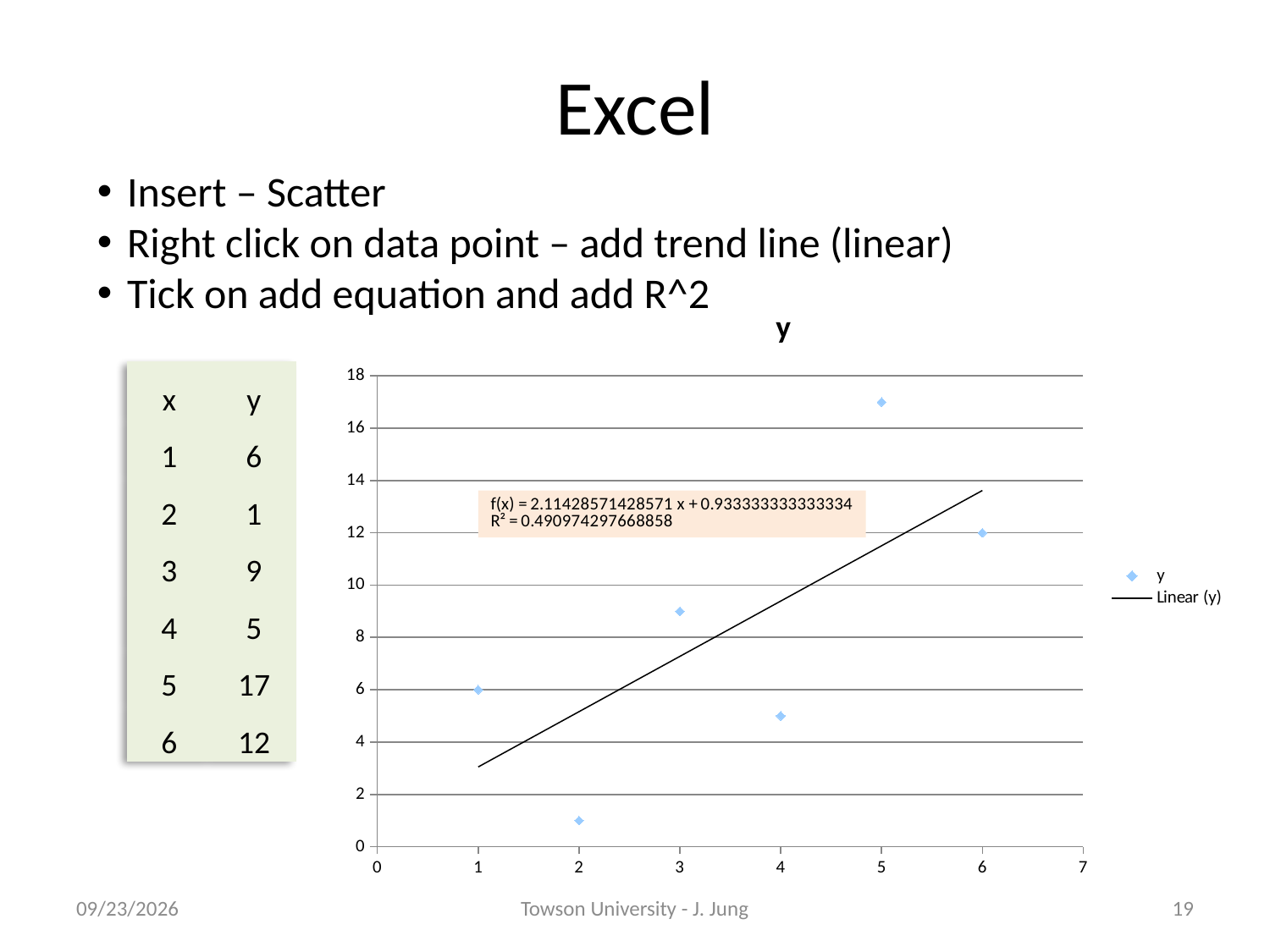
What is the R² value shown on the chart? 0.490974297668858 Is the y value at x = 1 greater or less than 4? greater How many entries does the chart legend list? 2 At which x value is y highest? 5 What is the y value at x = 2? 1 What kind of chart is shown on the slide? scatter chart Which is larger, the y value at x = 3 or the y value at x = 4? x = 3 How many data points are plotted in the chart? 6 What is the y value at x = 6? 12 What is the y value at x = 5? 17 What is the difference between the y value at x = 5 and the y value at x = 6? 5 At which x value is y lowest? 2